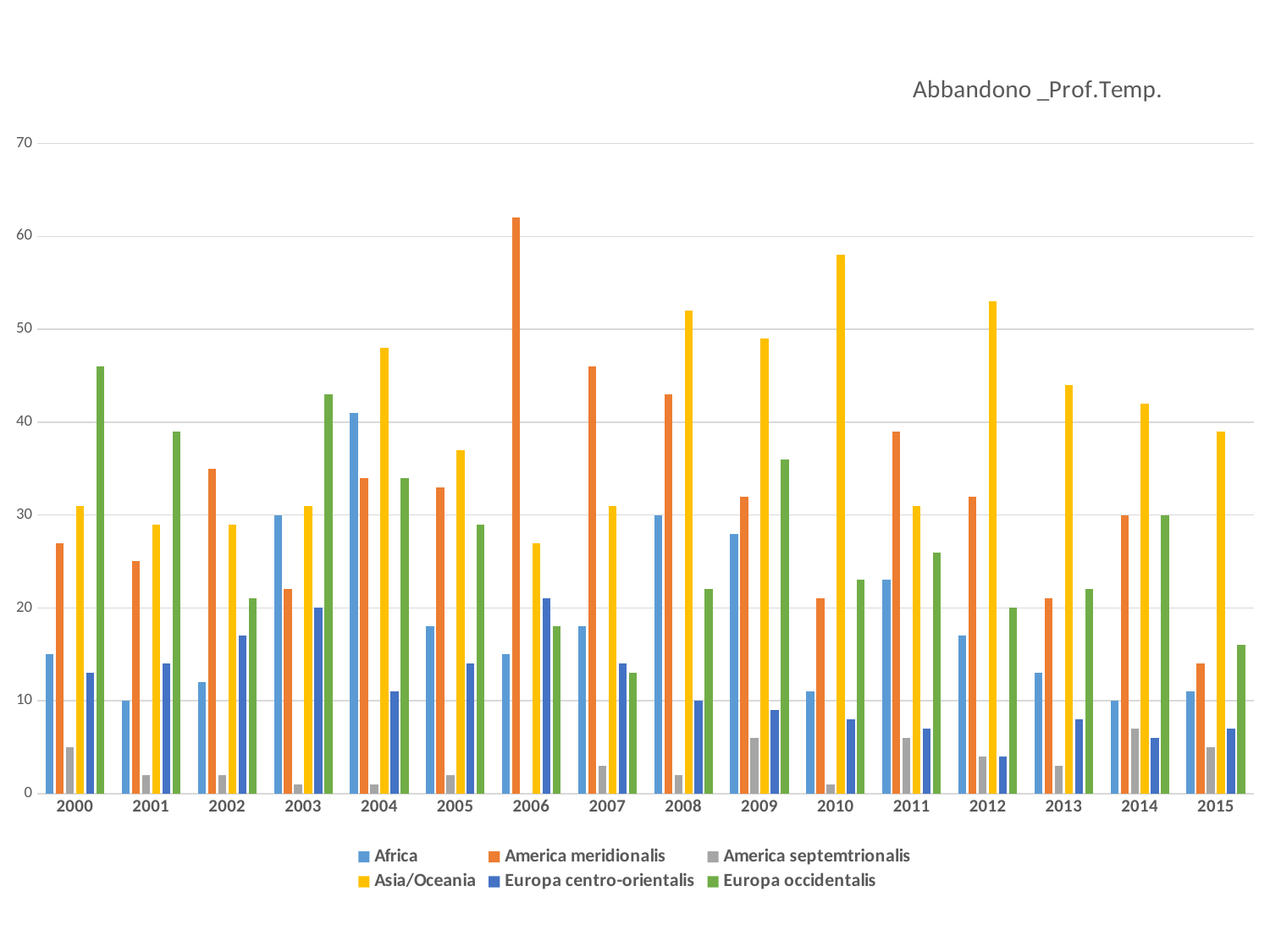
In 2010, which is larger: Asia/Oceania or America meridionalis? Asia/Oceania Is the value for America septemtrionalis in 2000 greater or less than 10? less Is the value for Asia/Oceania in 2010 greater or less than 50? greater What kind of chart is shown on the slide? bar chart In which year is the Europa occidentalis bar highest? 2000 In which year is the Asia/Oceania bar highest? 2010 How many series does the legend list? 6 Is the value for America meridionalis in 2006 greater or less than 60? greater How many years are shown on the x axis? 16 In which year is the America meridionalis bar highest? 2006 Do the Asia/Oceania values rise or fall from 2012 to 2015? fall What is the title of the chart? Abbandono _Prof.Temp.